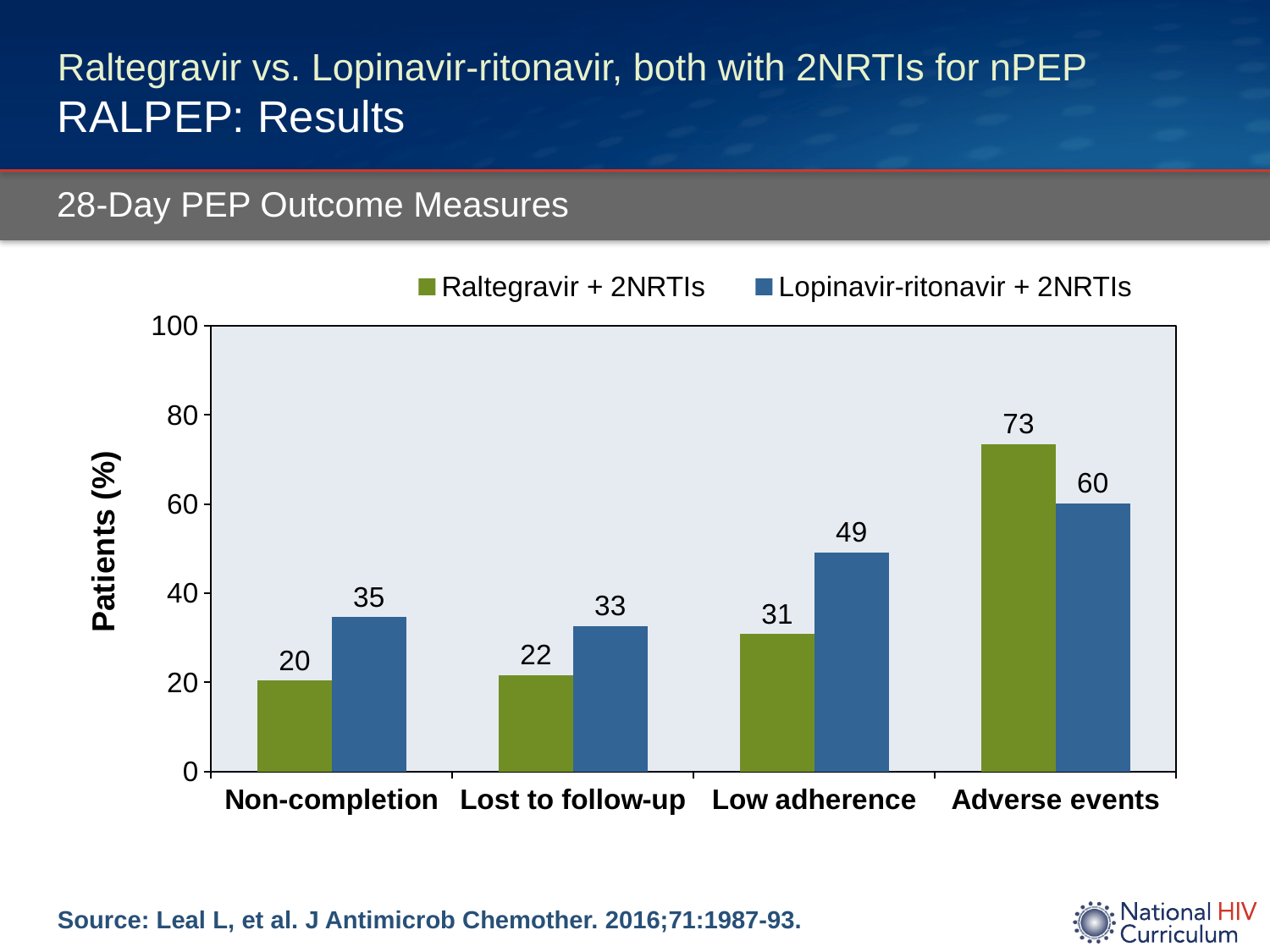
Which outcome measure has the lowest value for the Lopinavir-ritonavir + 2NRTIs group? Lost to follow-up What percentage of patients in the Raltegravir + 2NRTIs group had non-completion? 20 What is the difference between the Raltegravir + 2NRTIs and Lopinavir-ritonavir + 2NRTIs values for low adherence? 18 What is the value for adverse events in the Lopinavir-ritonavir + 2NRTIs group? 60 What is the label of the y axis? Patients (%) Is the value for lost to follow-up in the Lopinavir-ritonavir + 2NRTIs group greater or less than 40? less Which outcome measure has the highest value for the Raltegravir + 2NRTIs group? Adverse events How many series does the legend list? 2 How many outcome measure categories are shown on the x axis? 4 What kind of chart is shown on the slide? Bar chart What percentage of patients in the Lopinavir-ritonavir + 2NRTIs group had low adherence? 49 For adverse events, which group has the larger value: Raltegravir + 2NRTIs or Lopinavir-ritonavir + 2NRTIs? Raltegravir + 2NRTIs